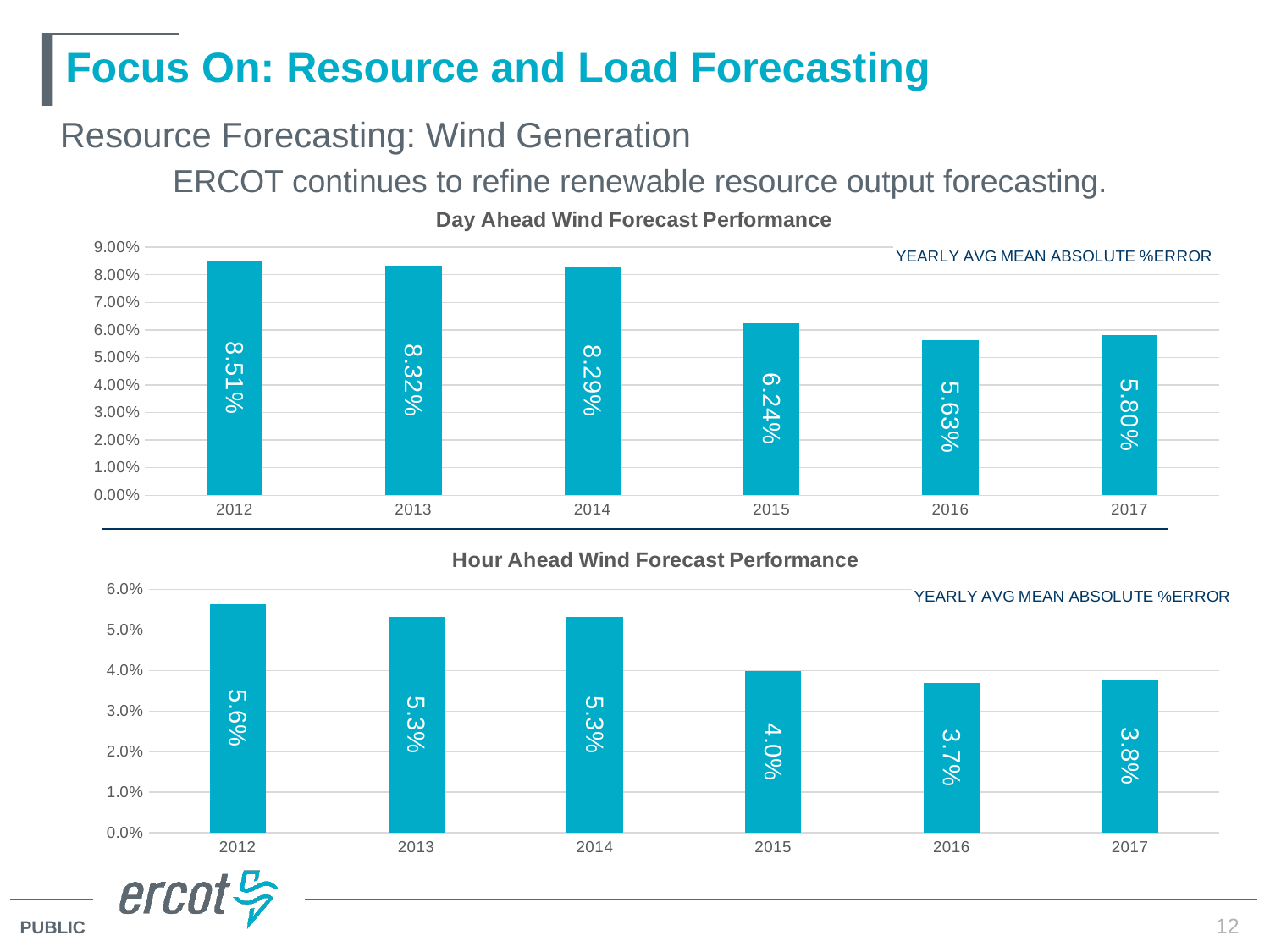
In the Hour Ahead Wind Forecast Performance chart, what is the difference between the 2014 and 2015 values? 1.3% In the Hour Ahead Wind Forecast Performance chart, which year has the highest value? 2012 How many years are shown in the Hour Ahead Wind Forecast Performance chart? 6 In the Day Ahead Wind Forecast Performance chart, what is the difference between the 2012 and 2017 values? 2.71% In the Day Ahead Wind Forecast Performance chart, what is the value for 2012? 8.51% In the Day Ahead Wind Forecast Performance chart, which year has the lowest value? 2016 In the Hour Ahead Wind Forecast Performance chart, do the values generally rise or fall from 2012 to 2016? Fall In the Day Ahead Wind Forecast Performance chart, which year has the highest value? 2012 In the Day Ahead Wind Forecast Performance chart, is the value for 2014 greater or less than 7.00%? greater In the Day Ahead Wind Forecast Performance chart, which is larger, the value for 2015 or the value for 2016? 2015 What kind of chart is the Day Ahead Wind Forecast Performance chart? Bar chart In the Hour Ahead Wind Forecast Performance chart, what is the value for 2016? 3.7%